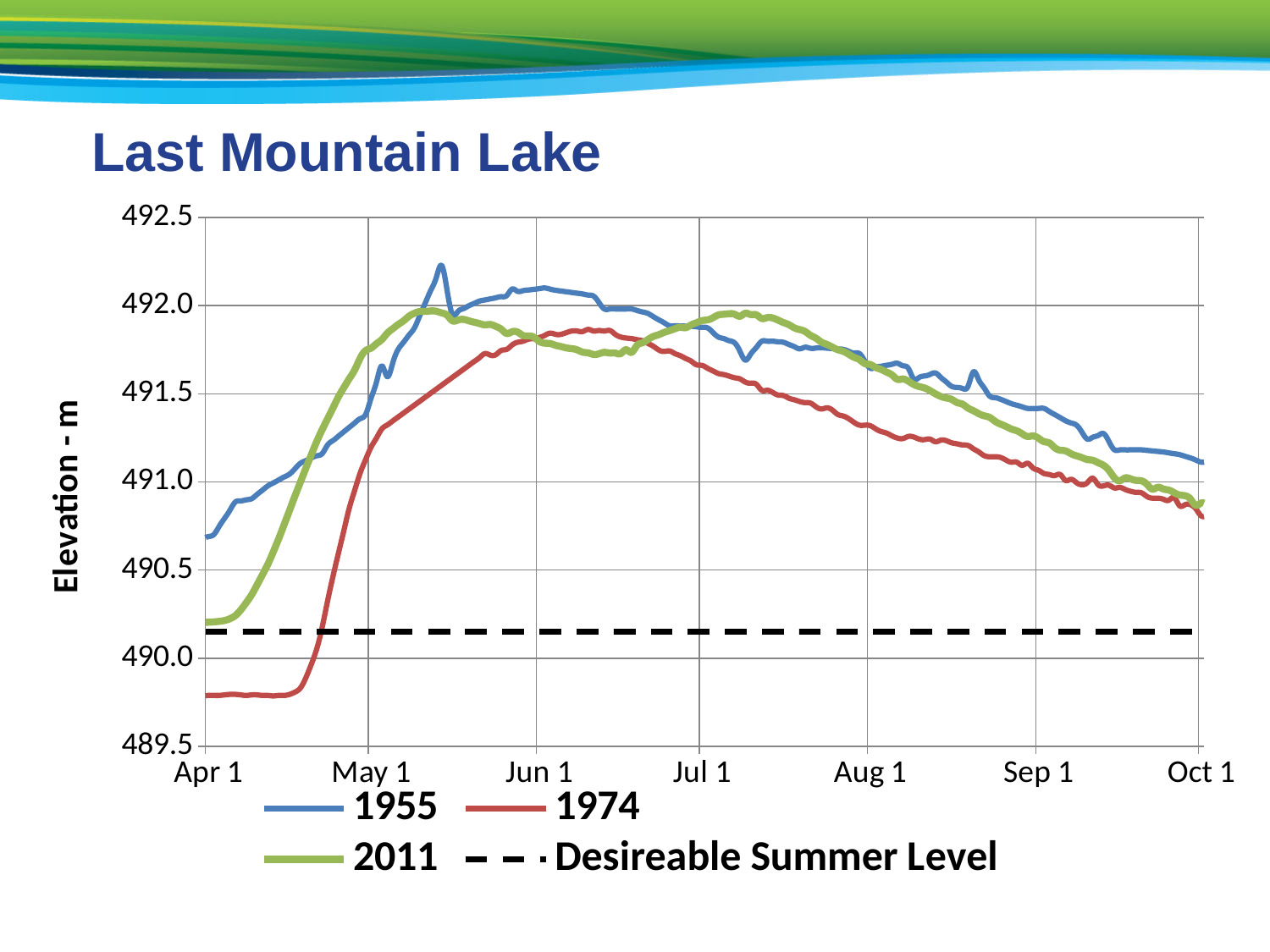
On Oct 1, which is larger, the value for 1955 or the value for 1974? 1955 Which series has the lowest value on Apr 1? 1974 What kind of chart is shown on the slide? line chart Is the value for 1974 on Apr 1 greater or less than 490.0? less Is the peak value of the 1955 series greater or less than 492.0? greater What is the label on the y axis? Elevation - m Does the 1974 series rise or fall from Jun 1 to Oct 1? fall Is the value for 1955 on Apr 1 greater or less than 490.5? greater What is the title of the chart? Last Mountain Lake How many series does the legend list? 4